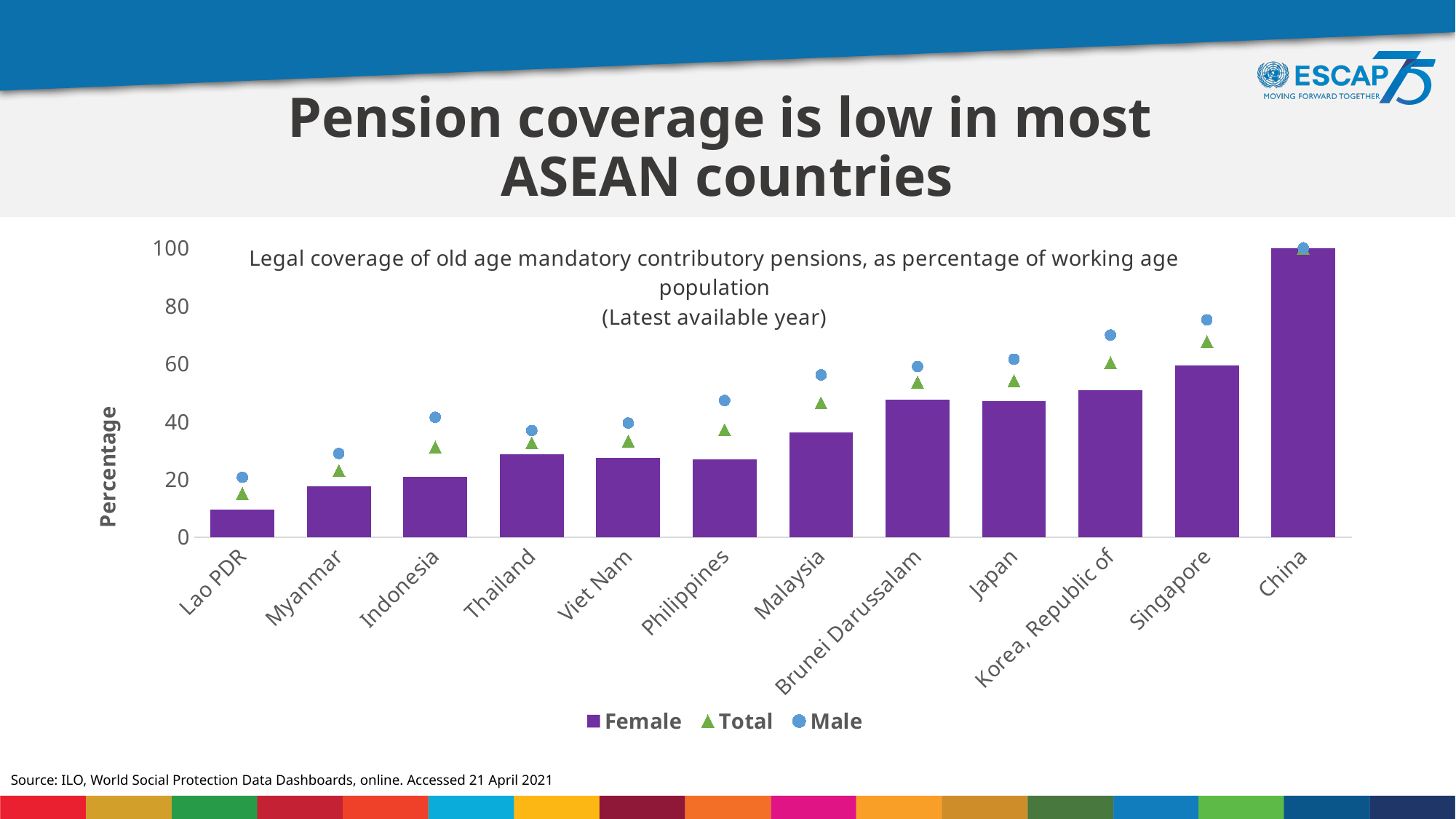
What kind of chart is shown on the slide? Bar chart Is the Male value for Korea, Republic of greater or less than 60? greater How many countries are shown on the x axis of the chart? 12 How many series does the chart legend list? 3 Is the Female value for Singapore greater or less than 40? greater Which series in the legend is shown with green triangle markers? Total Do the Female bars generally rise or fall moving from left to right along the x axis? Rise Which country has the highest Female pension coverage bar? China Which country has the lowest Female pension coverage bar? Lao PDR Is the Total value for Thailand greater or less than 40? less Which has a larger Female value, Malaysia or Myanmar? Malaysia